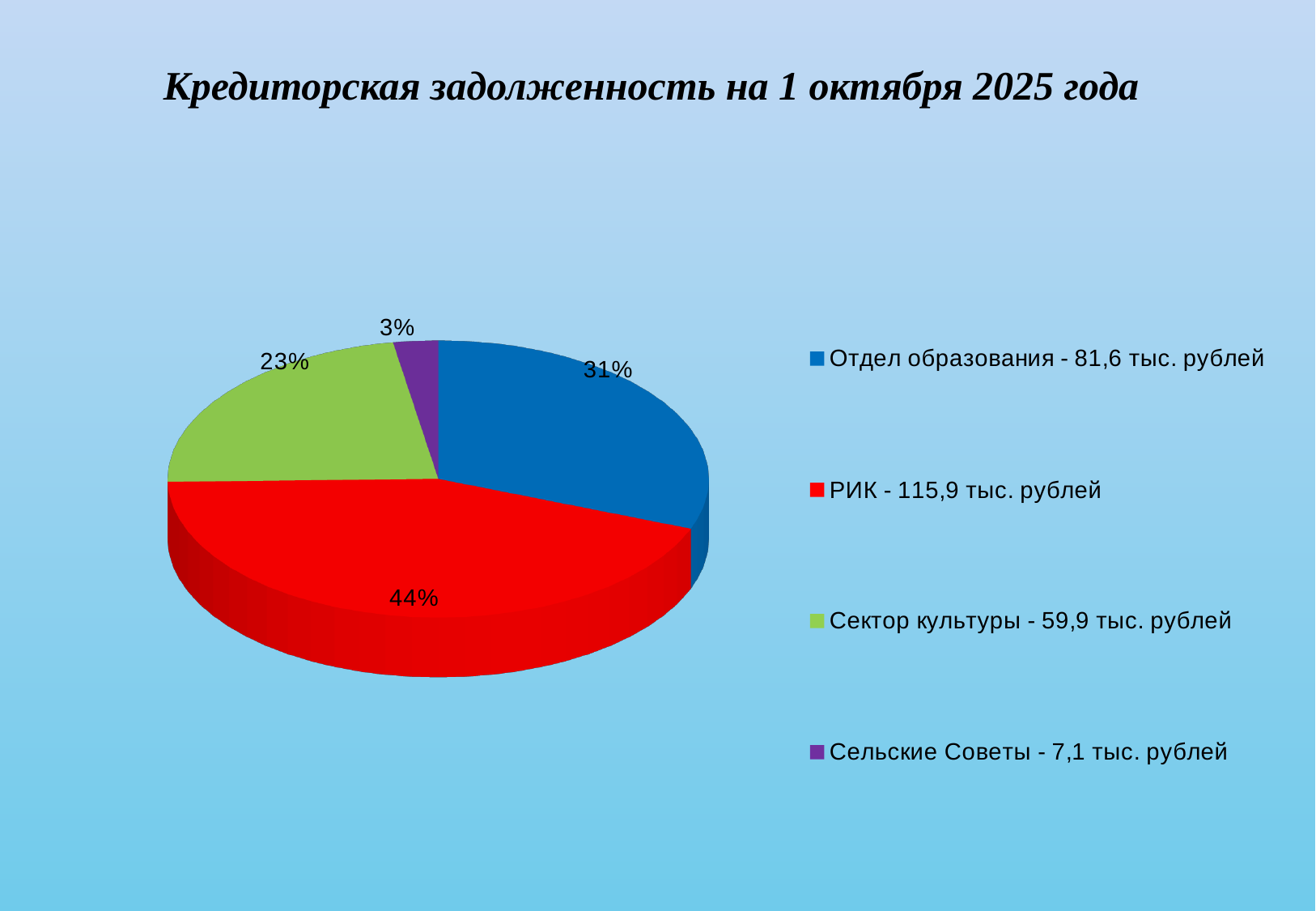
What share of the pie does Сельские Советы account for? 3% What kind of chart is shown on the slide? pie chart Which category has the largest slice of the pie? РИК Which category has the smallest slice of the pie? Сельские Советы What share of the pie does РИК account for? 44% Which is larger, the slice for Сектор культуры or the slice for Отдел образования? Отдел образования What share of the pie does Сектор культуры account for? 23% What is the difference in percentage points between the РИК slice and the Отдел образования slice? 13% According to the legend, what amount in тыс. рублей is given for Сектор культуры? 59,9 тыс. рублей How many slices does the pie chart have? 4 What is the title of the chart on the slide? Кредиторская задолженность на 1 октября 2025 года